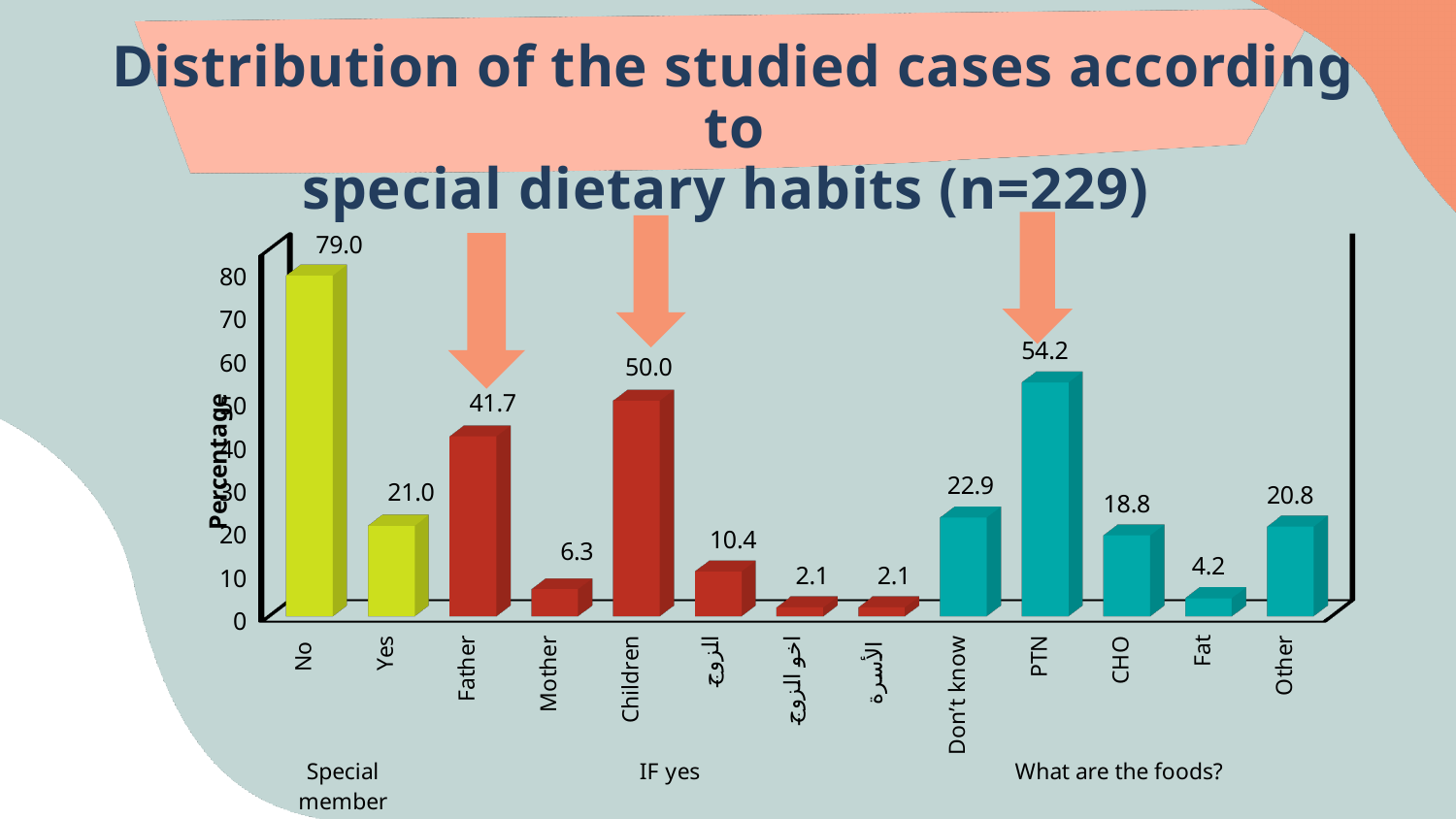
How many bars are plotted on the chart? 13 What is the label of the vertical axis? Percentage Which is larger, the value for "Children" or the value for "Father"? Children Within the What are the foods? group, which category has the lowest value? Fat What is the difference between the values for "No" and "Yes"? 58.0 What is the difference between the values for "Don't know" and "CHO"? 4.1 Which category has the highest value on the chart? No What is the value for "PTN" in the What are the foods? group? 54.2 What is the value for "Father" in the IF yes group? 41.7 What kind of chart is shown on the slide? Bar chart What is the value for "No" under Special member? 79.0 What is the value for "Fat"? 4.2